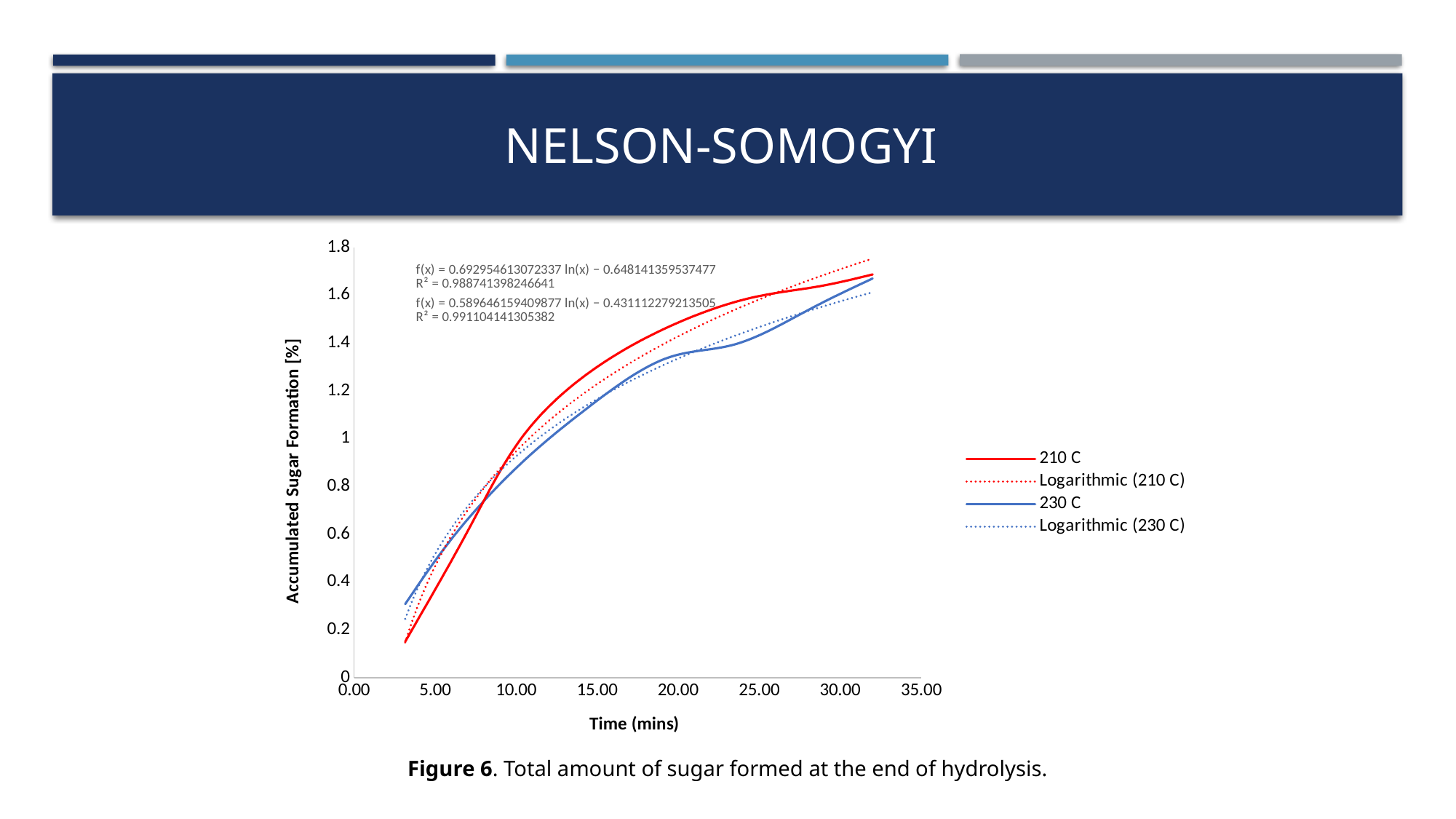
What is the label of the y axis of the chart? Accumulated Sugar Formation [%] How many entries does the chart legend list? 4 Does the 210 C series rise or fall as time increases along the x axis? rise Does the 230 C series rise or fall as time increases along the x axis? rise Is the value for 230 C at 5.00 mins greater or less than 0.6? less Is the value for 210 C at 20.00 mins greater or less than 1.2? greater Which series reaches the highest accumulated sugar formation at the end of the measured time? 210 C At 5.00 mins, which series has the higher accumulated sugar formation, 210 C or 230 C? 230 C What is the R² value printed for the first trendline equation on the chart? 0.988741398246641 At 30.00 mins, which series has the higher accumulated sugar formation, 210 C or 230 C? 210 C What kind of chart is shown on the slide? line chart Is the value for 210 C at 30.00 mins greater or less than 1.4? greater